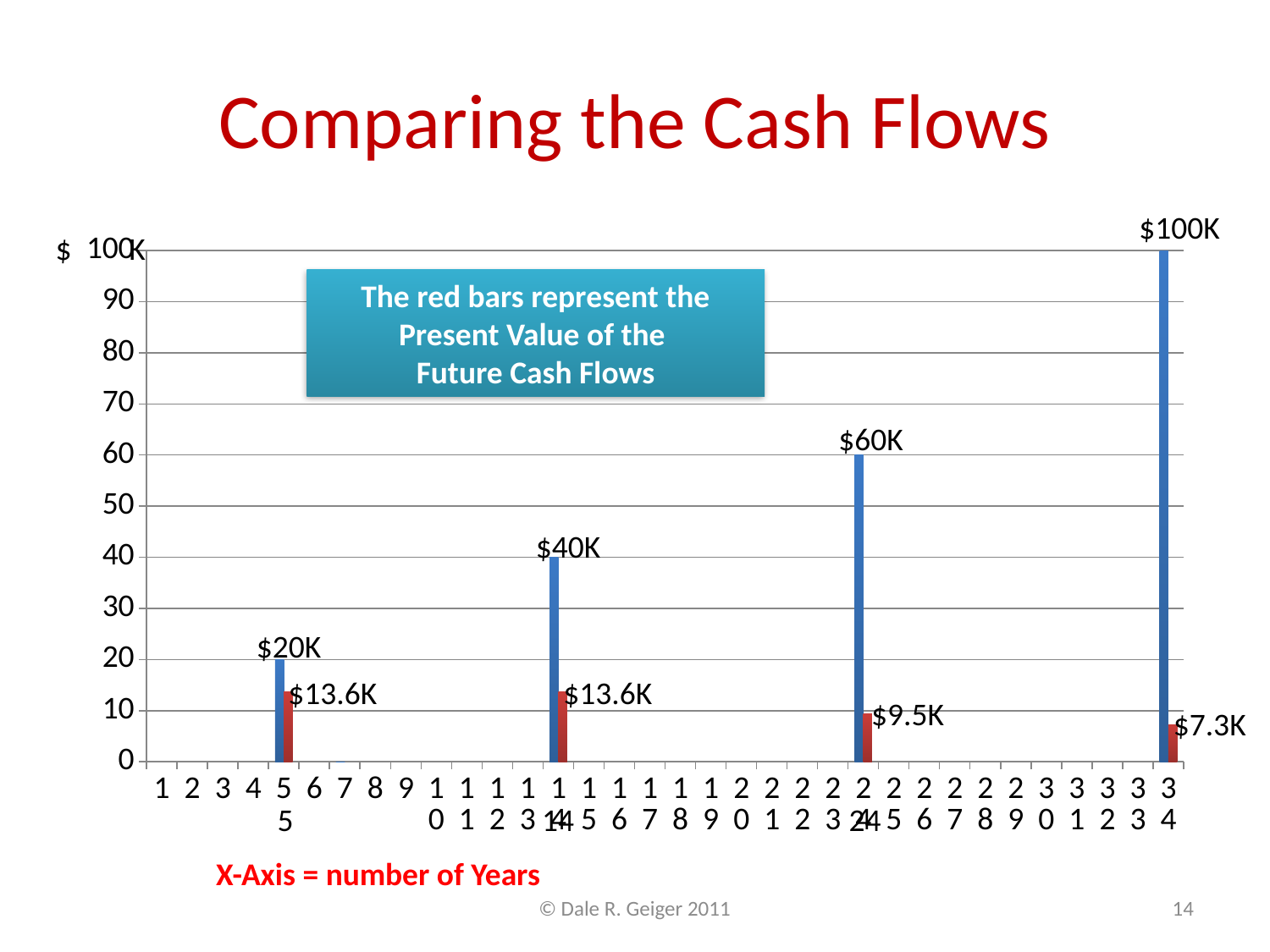
What is the value of the red bar at year 24? $9.5K Do the blue bar values rise or fall as the number of years increases? rise Which is larger, the blue bar at year 24 or the blue bar at year 14? the blue bar at year 24 What is the difference between the blue bar and the red bar at year 14? $26.4K According to the text box on the chart, what do the red bars represent? the Present Value of the Future Cash Flows What is the value of the blue bar at year 5? $20K What is the value of the blue bar at year 34? $100K Do the red bar values rise or fall from year 14 to year 34? fall What is the value of the red bar at year 34? $7.3K At which year is the red bar the lowest? 34 At which year is the blue bar the highest? 34 What kind of chart is shown on the slide? bar chart